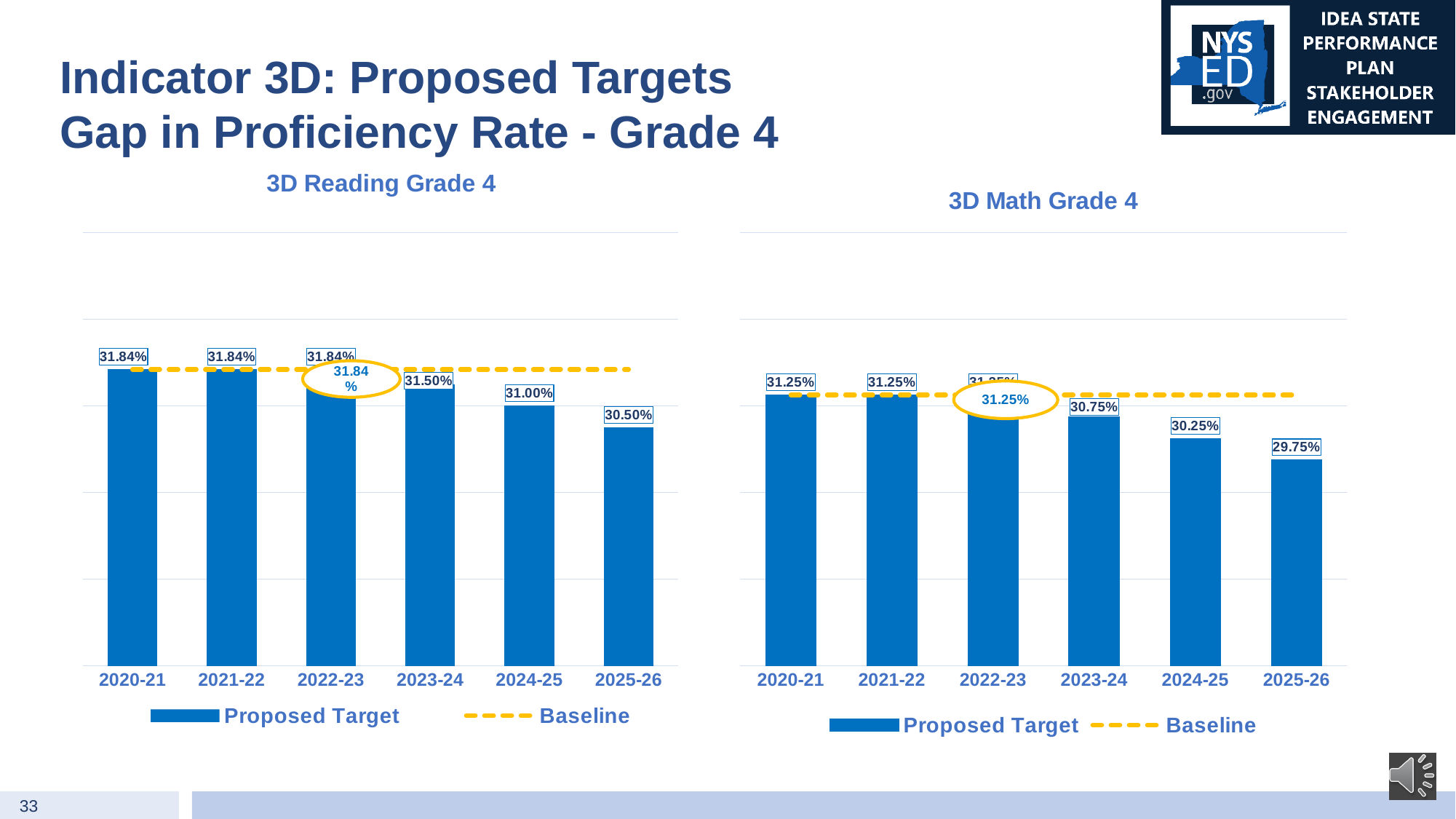
How many years are shown on the x axis of the 3D Reading Grade 4 chart? 6 In the 3D Math Grade 4 chart, which year has the lowest proposed target? 2025-26 In the 3D Reading Grade 4 chart, what is the proposed target for 2025-26? 30.50% In the 3D Reading Grade 4 chart, do the proposed targets rise or fall from 2022-23 to 2025-26? fall In the 3D Reading Grade 4 chart, what is the difference between the proposed targets for 2020-21 and 2025-26? 1.34% In the 3D Reading Grade 4 chart, what is the proposed target for 2023-24? 31.50% In the 3D Math Grade 4 chart, which is larger, the proposed target for 2023-24 or for 2025-26? 2023-24 How many series does the legend of the 3D Math Grade 4 chart list? 2 In the 3D Math Grade 4 chart, what is the baseline value shown in the circled label? 31.25% In the 3D Math Grade 4 chart, what is the proposed target for 2024-25? 30.25% In the 3D Math Grade 4 chart, what is the difference between the proposed targets for 2023-24 and 2025-26? 1.00% In the 3D Reading Grade 4 chart, which year has the lowest proposed target? 2025-26